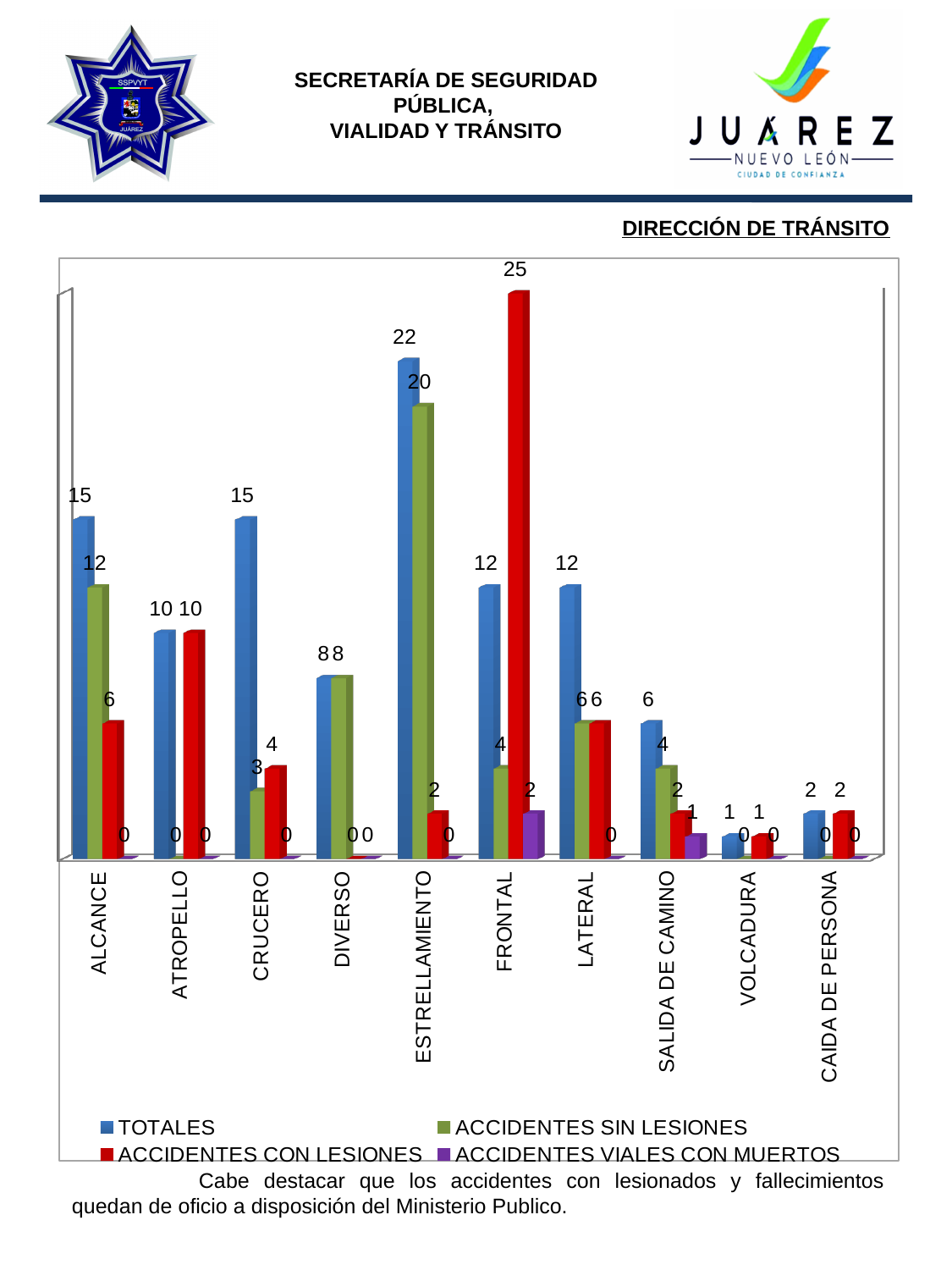
What is the ACCIDENTES CON LESIONES value for FRONTAL? 25 What is the ACCIDENTES SIN LESIONES value for ALCANCE? 12 Which series is shown in red in the legend? ACCIDENTES CON LESIONES What is the TOTALES value for ESTRELLAMIENTO? 22 What is the ACCIDENTES VIALES CON MUERTOS value for SALIDA DE CAMINO? 1 Which is larger, the ACCIDENTES CON LESIONES value for ATROPELLO or for ALCANCE? ATROPELLO How many series does the legend list? 4 What is the difference between the TOTALES values for ESTRELLAMIENTO and ALCANCE? 7 How many categories are shown on the x axis? 10 What kind of chart is shown on the slide? Bar chart Which category has the highest TOTALES value? ESTRELLAMIENTO Which category has the lowest TOTALES value? VOLCADURA